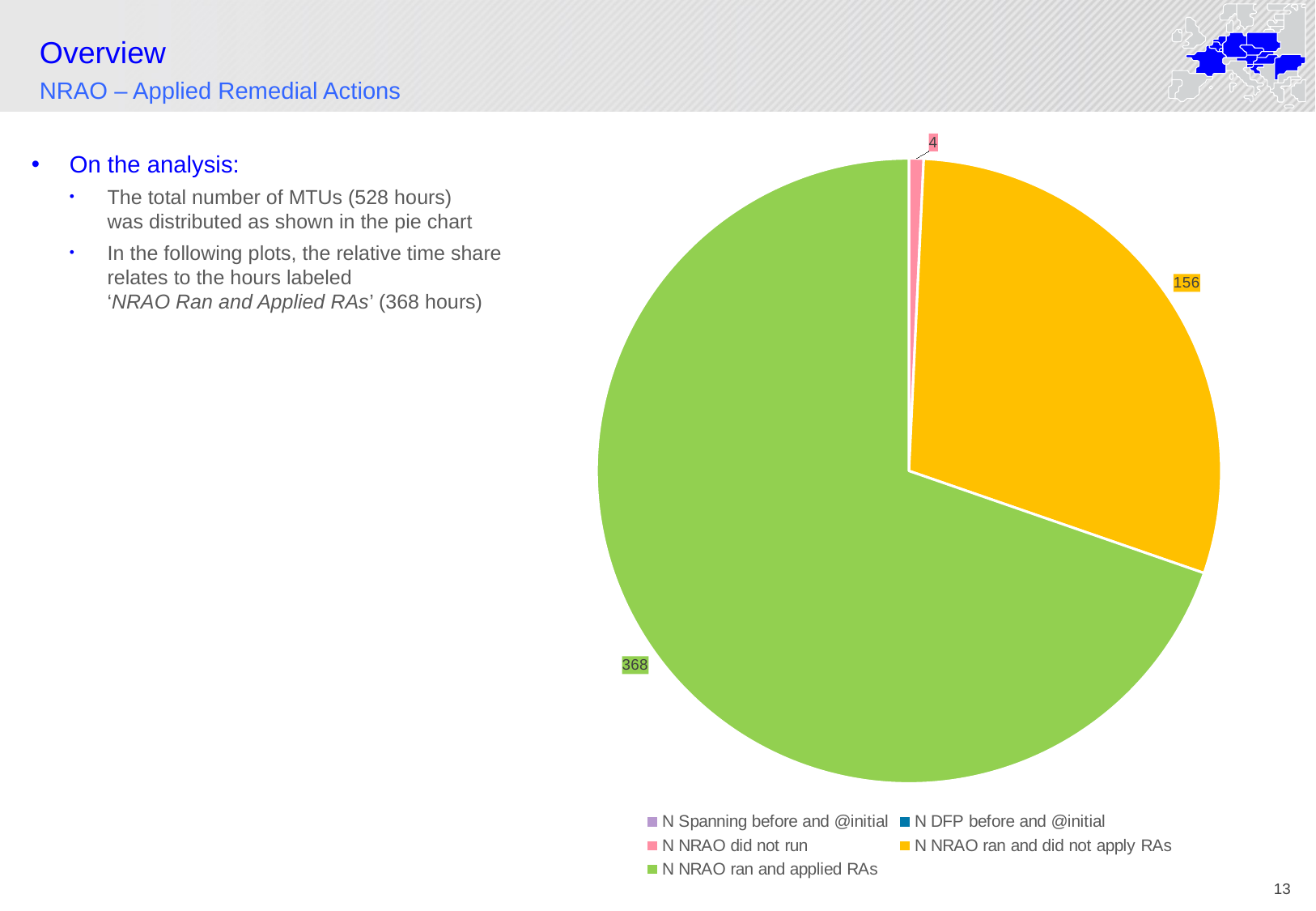
What type of chart is shown on the slide? pie chart How many entries does the legend of the pie chart list? 5 What is the value for 'N NRAO did not run' in the pie chart? 4 What colour is the slice for 'N NRAO ran and did not apply RAs'? yellow Which labeled slice in the pie chart has the smallest value? N NRAO did not run Which is larger: the value for 'N NRAO ran and did not apply RAs' or the value for 'N NRAO did not run'? N NRAO ran and did not apply RAs What is the difference between the values for 'N NRAO ran and applied RAs' and 'N NRAO ran and did not apply RAs'? 212 What is the value for 'N NRAO ran and applied RAs' in the pie chart? 368 Which category has the largest slice in the pie chart? N NRAO ran and applied RAs What is the value for 'N NRAO ran and did not apply RAs' in the pie chart? 156 What is the total of the three labeled slices in the pie chart? 528 What share of the pie does the 'N NRAO ran and applied RAs' slice represent, based on the labeled values? 69.7%